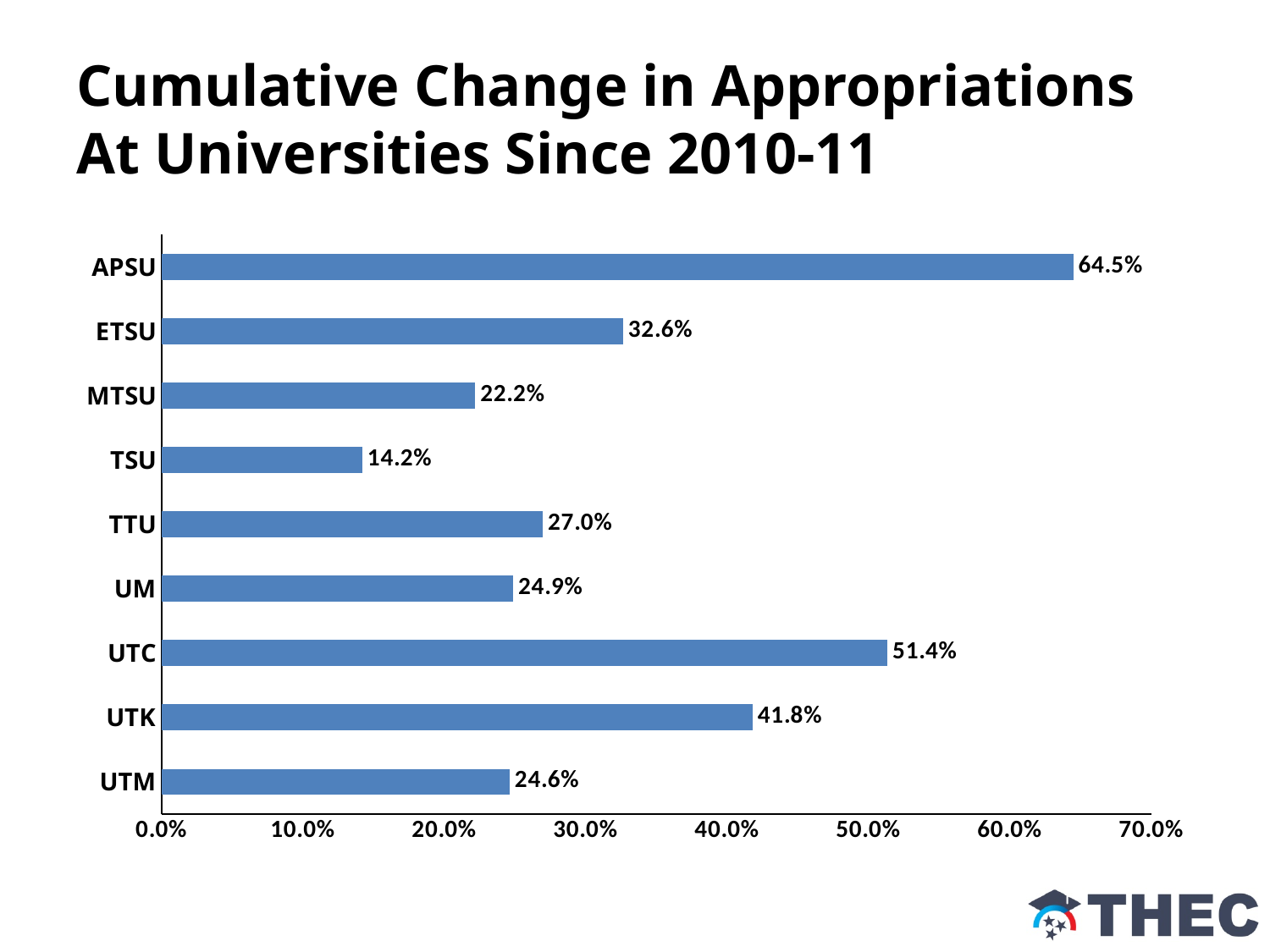
What is the cumulative change in appropriations for TSU? 14.2% Which university has the lowest cumulative change in appropriations? TSU Is the value for UTC greater or less than 50.0%? greater How many universities are shown in the chart? 9 What kind of chart is shown on the slide? Bar chart What is the cumulative change in appropriations for APSU? 64.5% Which has a larger cumulative change, ETSU or TTU? ETSU What is the cumulative change in appropriations for UTK? 41.8% What is the title of the chart? Cumulative Change in Appropriations At Universities Since 2010-11 What is the difference between the values for APSU and ETSU? 31.9% What is the difference between the values for UTC and UTK? 9.6% Which university has the highest cumulative change in appropriations? APSU